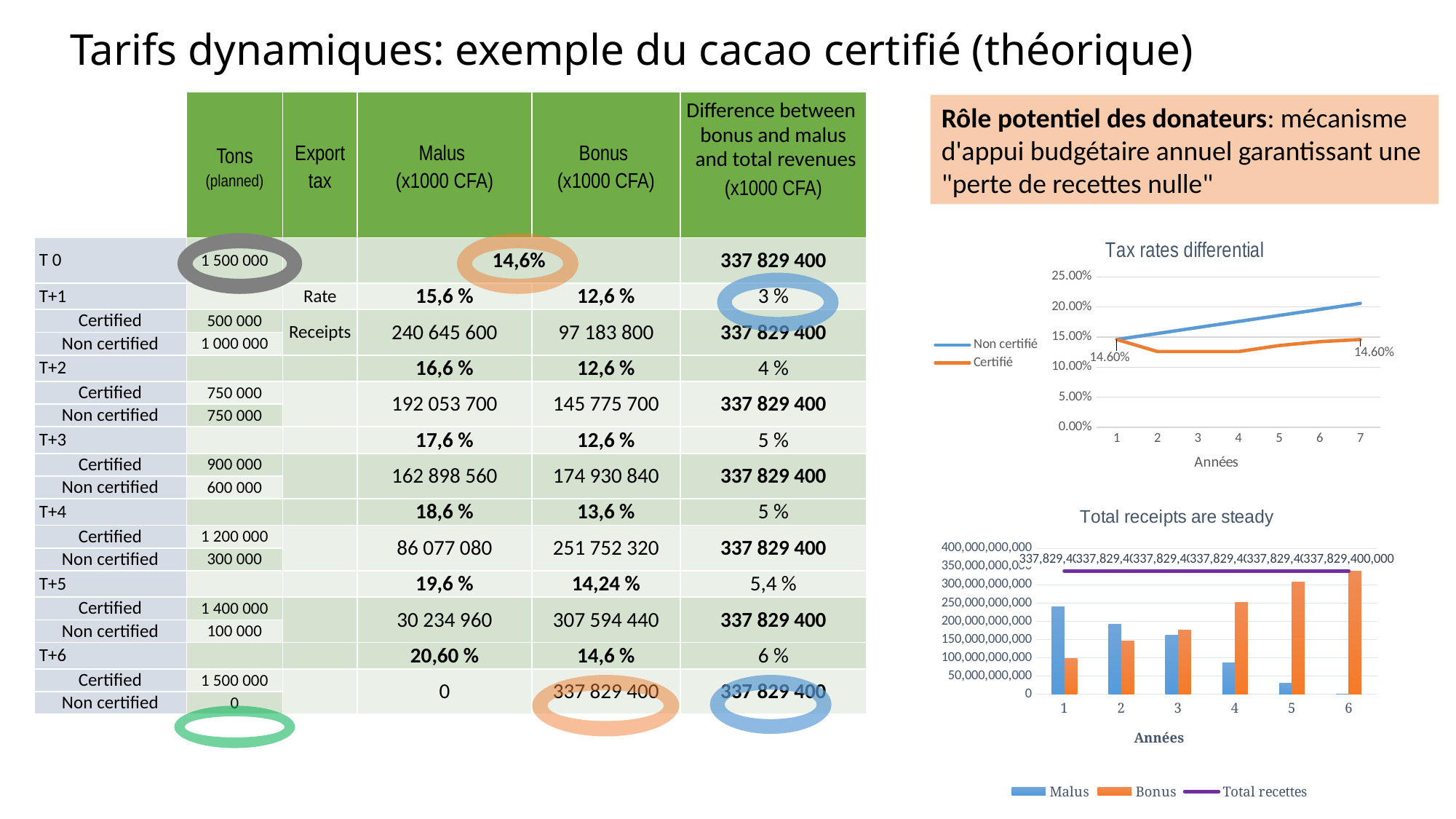
How many series does the legend of the 'Total receipts are steady' chart list? 3 How many years are shown on the x axis of the 'Total receipts are steady' chart? 6 How many series does the legend of the 'Tax rates differential' chart list? 2 In the 'Total receipts are steady' chart, is the Malus value at year 1 greater or less than 200,000,000,000? greater In the 'Tax rates differential' chart, what is the value of Certifié at year 1? 14.60% In the 'Total receipts are steady' chart, which is larger at year 1, Malus or Bonus? Malus What kind of chart is the 'Tax rates differential' chart? line chart In the 'Tax rates differential' chart, does the Non certifié line rise or fall from year 1 to year 7? rise In the 'Tax rates differential' chart, what is the value of Certifié at year 7? 14.60% In the 'Tax rates differential' chart, is the Non certifié value at year 7 greater or less than 15.00%? greater In the 'Total receipts are steady' chart, which year has the highest Bonus value? 6 In the 'Total receipts are steady' chart, does the Bonus series rise or fall across the years? rise